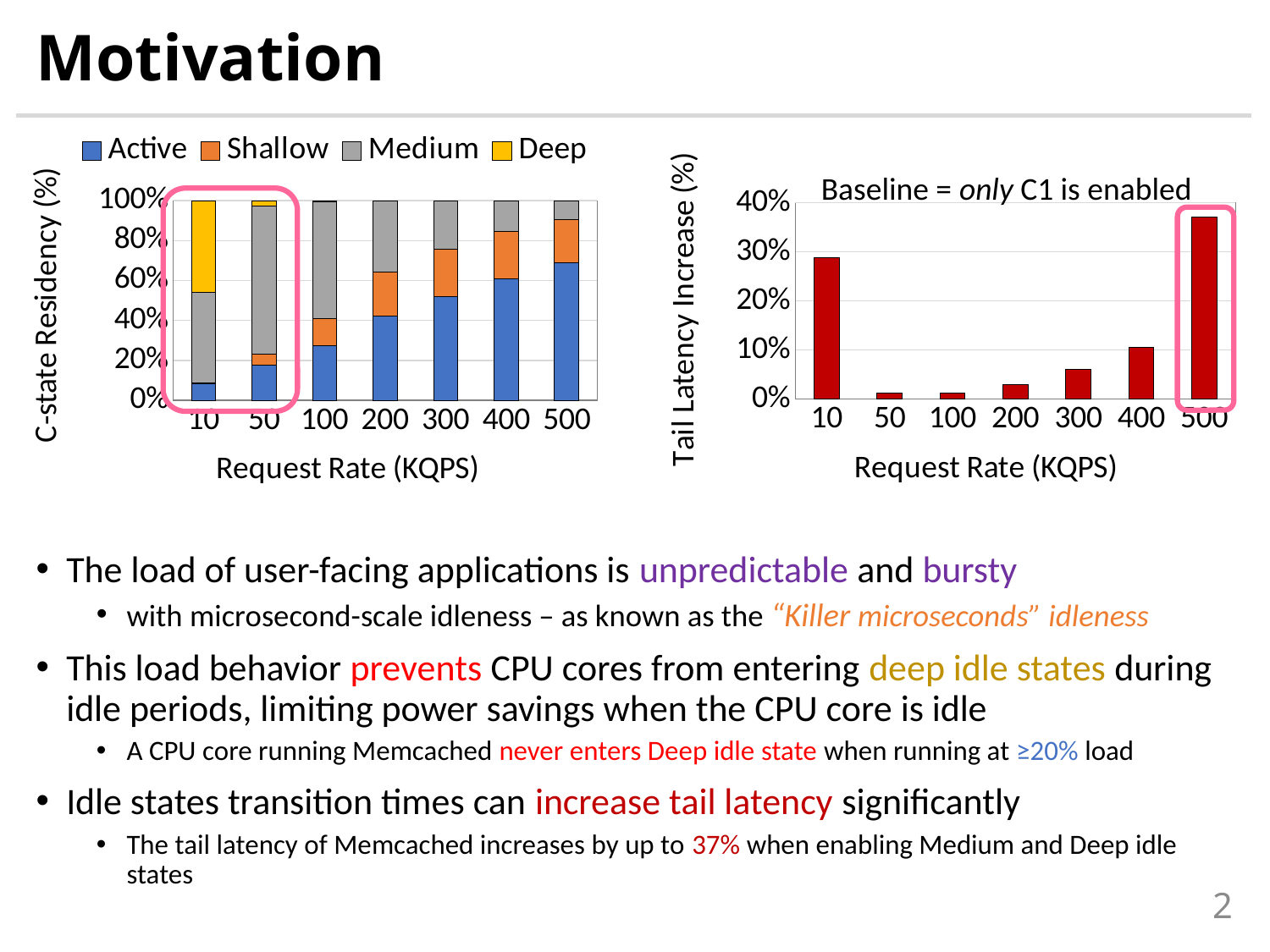
In the right chart (Tail Latency Increase), which request rate has the highest tail latency increase? 500 In the right chart (Tail Latency Increase), is the value for request rate 500 greater or less than 30%? greater What kind of chart is the left chart (C-state Residency)? stacked bar chart In the left chart (C-state Residency), is the Active share at request rate 10 greater or less than 20%? less What kind of chart is the right chart (Tail Latency Increase)? bar chart In the left chart (C-state Residency), does the Active share rise or fall as the request rate increases along the x axis? rise In the left chart (C-state Residency), is the Active share at request rate 500 greater or less than 60%? greater In the right chart (Tail Latency Increase), what baseline is stated in the annotation above the bars? Baseline = only C1 is enabled In the left chart (C-state Residency), how many request rate categories are shown on the x axis? 7 In the left chart (C-state Residency), how many series does the legend list? 4 In the right chart (Tail Latency Increase), which is larger: the value for request rate 10 or the value for request rate 400? 10